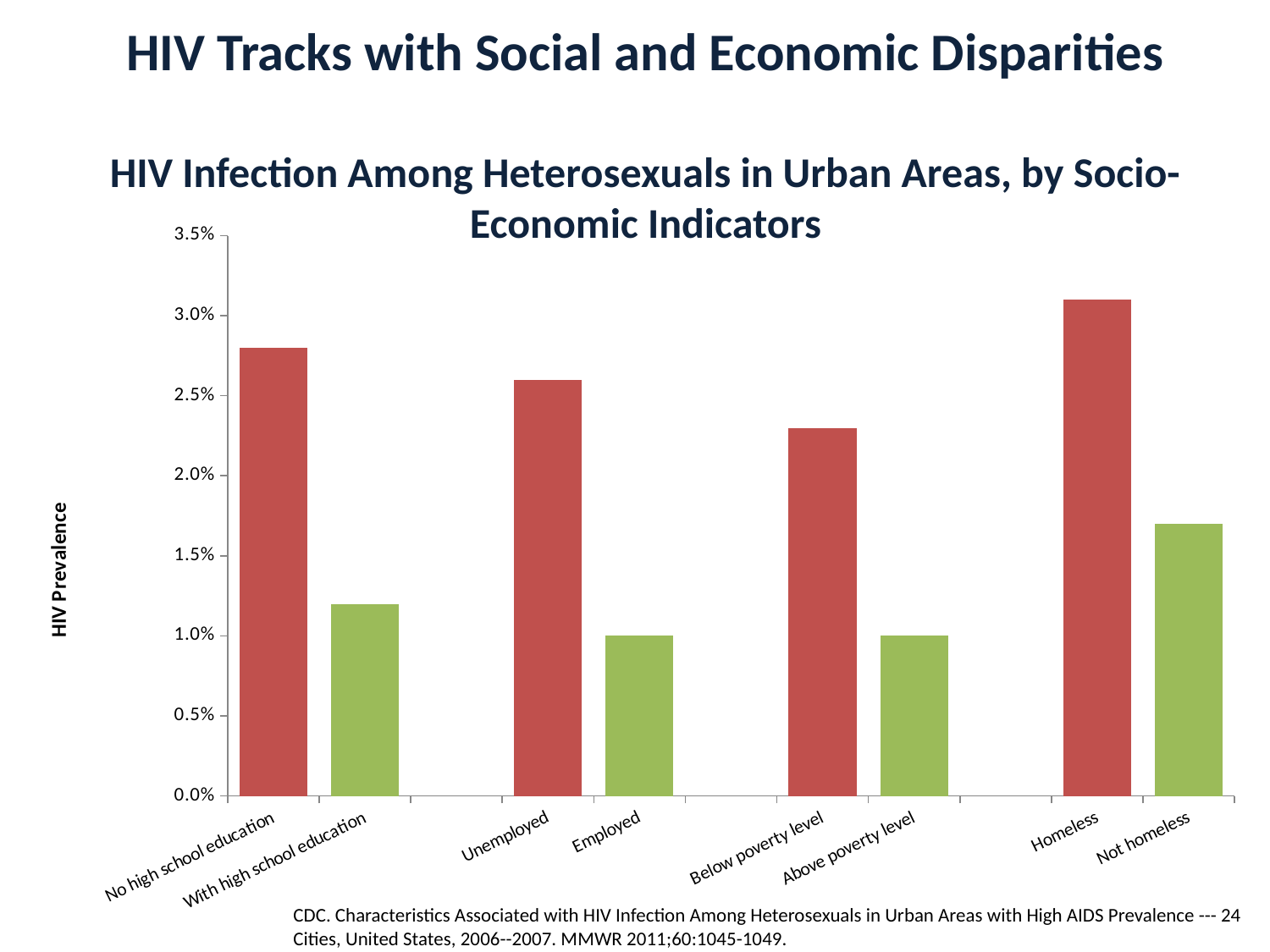
How many categories are plotted along the x axis? 8 What kind of chart is shown on the slide? bar chart Which category has the highest HIV prevalence? Homeless What is the label of the vertical axis? HIV Prevalence Which is larger, the HIV prevalence for Not homeless or for With high school education? Not homeless Which is larger, the HIV prevalence for Unemployed or for Employed? Unemployed Is the HIV prevalence for Not homeless greater or less than 1.5%? greater Is the HIV prevalence for Below poverty level greater or less than 2.0%? greater Is the HIV prevalence for No high school education greater or less than 2.5%? greater